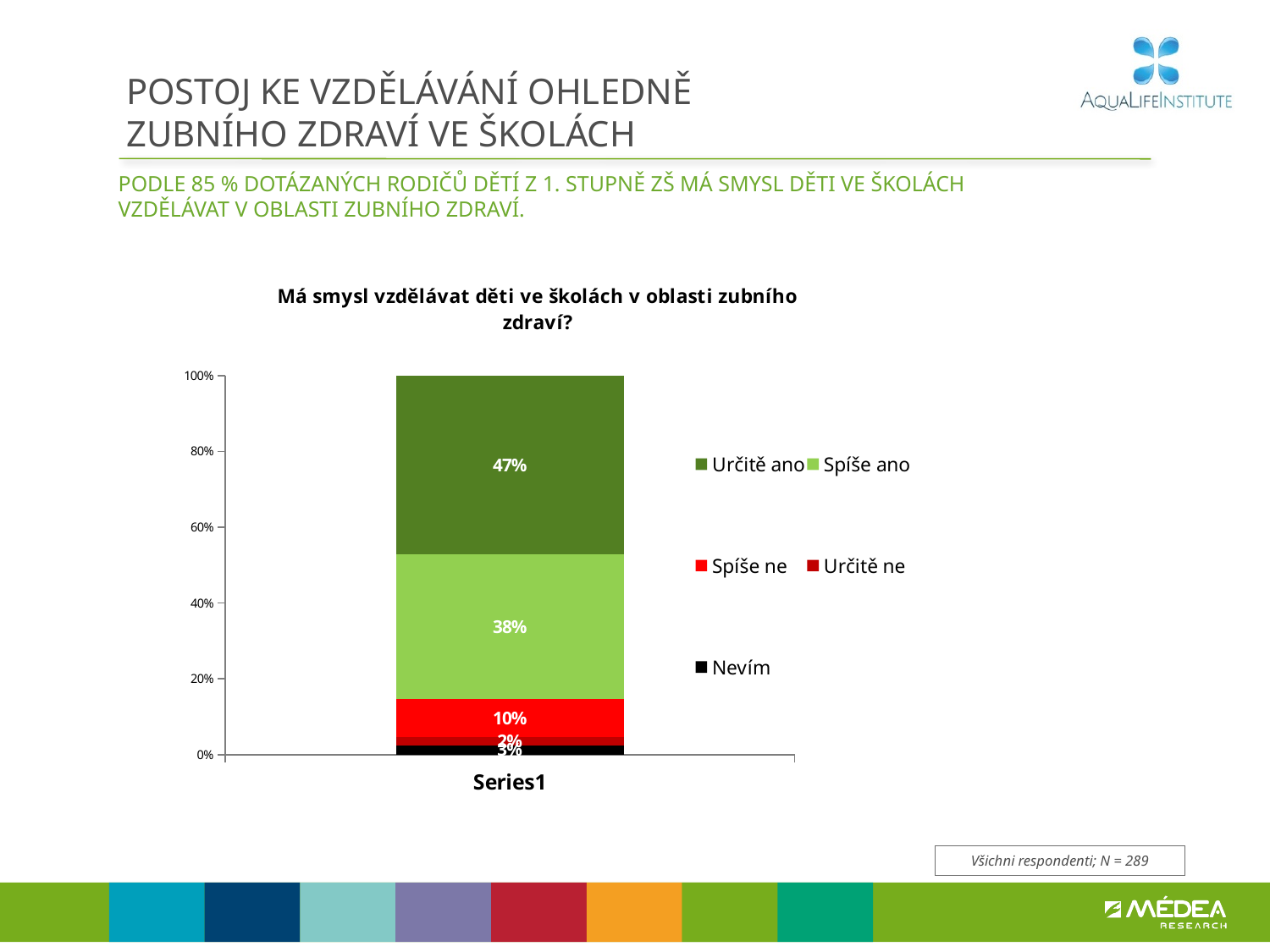
What kind of chart is shown on the slide? stacked bar chart What percentage of respondents answered "Spíše ne"? 10% Which is larger, the share for "Spíše ano" or the share for "Spíše ne"? Spíše ano How many bars are plotted in the chart? 1 What is the difference in percentage points between "Určitě ano" and "Spíše ano"? 9 percentage points What is the title of the chart? Má smysl vzdělávat děti ve školách v oblasti zubního zdraví? What colour represents "Nevím" in the chart? black What percentage of respondents answered "Určitě ano"? 47% Which answer category has the largest share in the bar? Určitě ano How many answer categories does the legend list? 5 What percentage of respondents answered "Spíše ano"? 38% What is the difference in percentage points between "Určitě ano" and "Spíše ne"? 37 percentage points